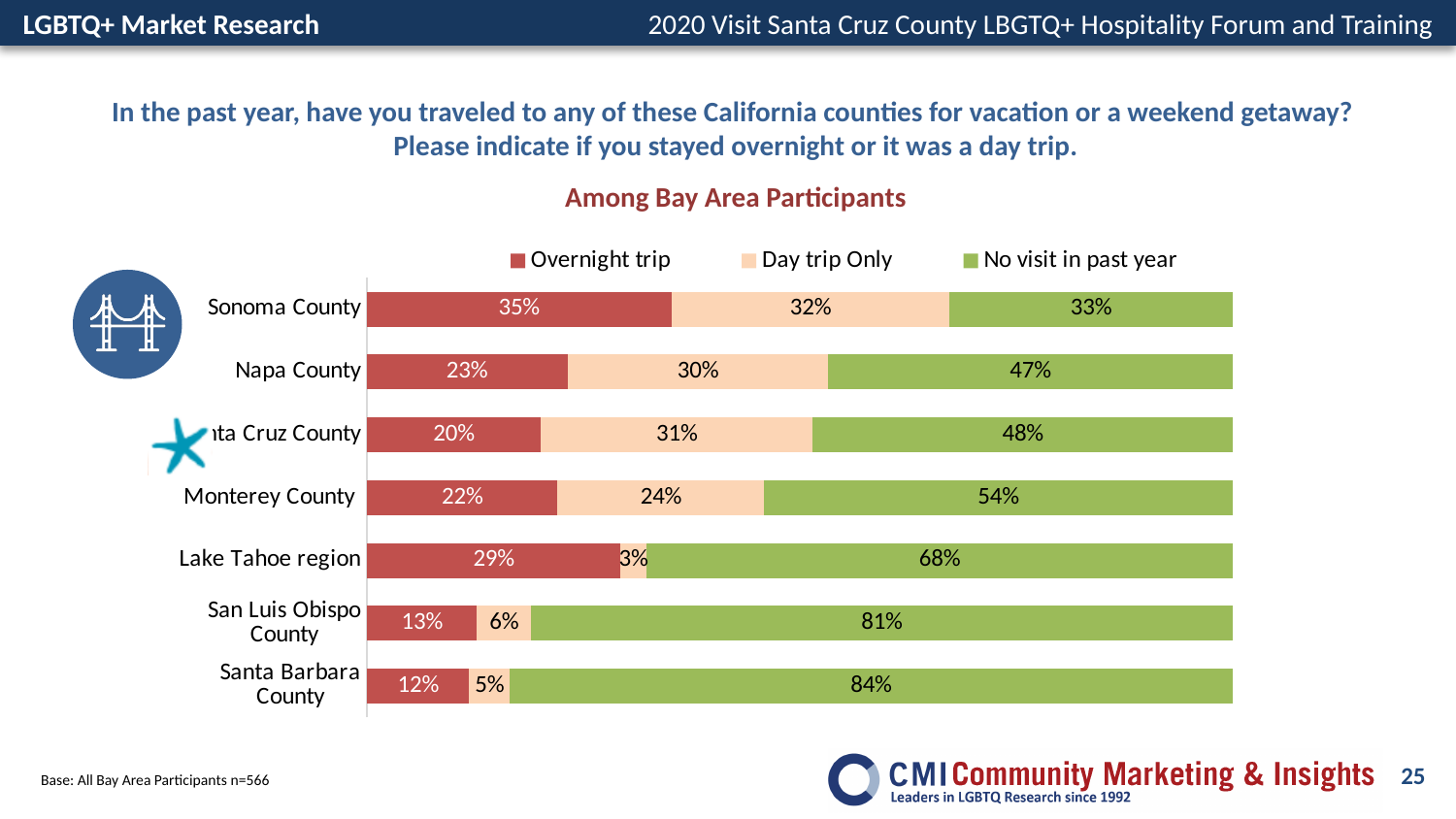
Which legend entry is shown in green? No visit in past year How many counties or regions are shown in the chart? 7 Which is larger: the 'Overnight trip' value for Lake Tahoe region or for Napa County? Lake Tahoe region Which county or region has the lowest 'Day trip Only' percentage? Lake Tahoe region What percentage of Bay Area participants reported no visit in the past year to Santa Barbara County? 84% Which county or region has the highest 'Overnight trip' percentage? Sonoma County How many series does the legend list? 3 What is the 'Day trip Only' value for Monterey County? 24% What is the total of the three segments for the San Luis Obispo County bar? 100% What is the difference between the 'No visit in past year' values for Napa County and Sonoma County? 14 percentage points What percentage of Bay Area participants took an overnight trip to Sonoma County? 35% What kind of chart is shown on the slide? Stacked bar chart